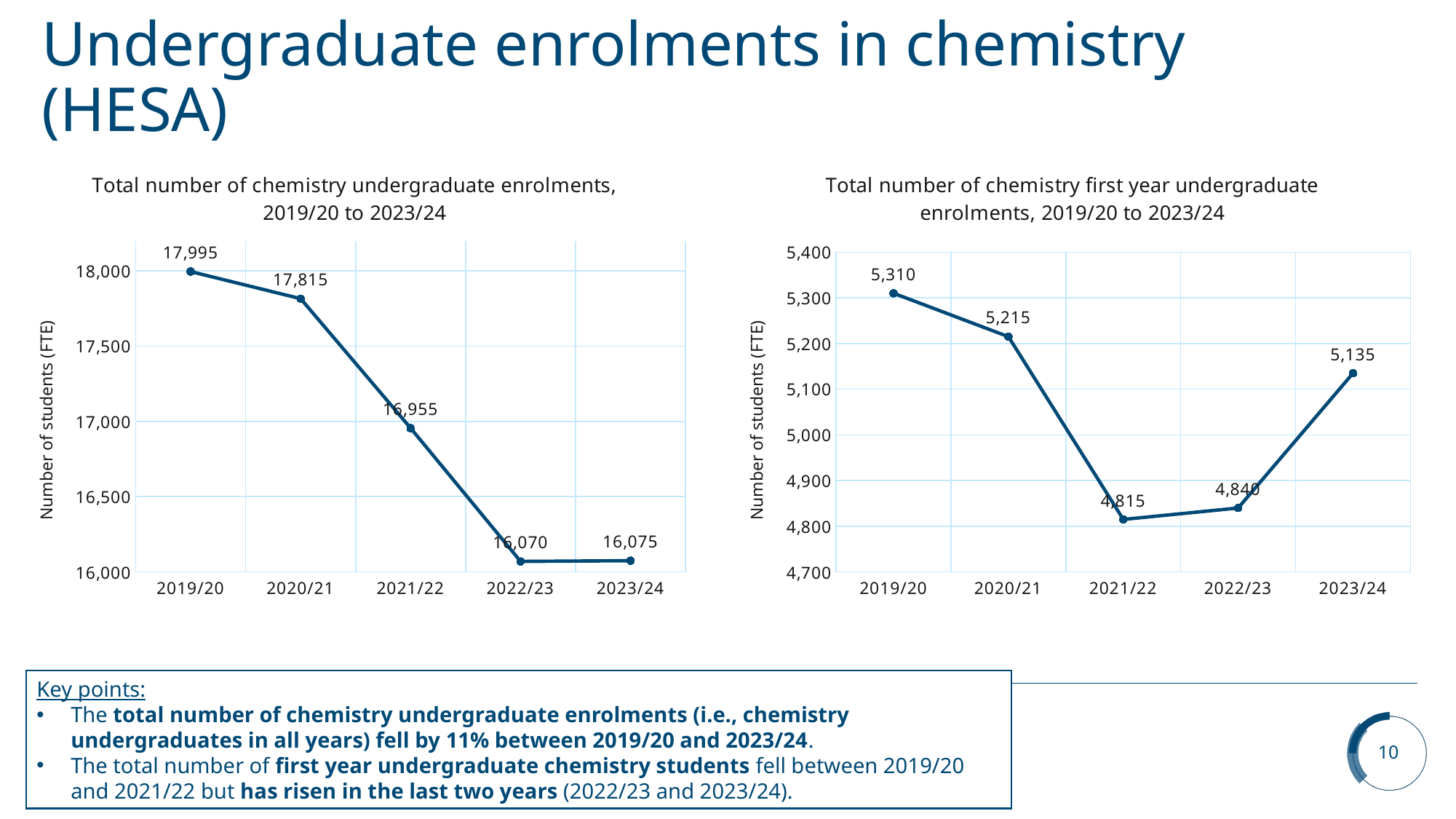
In the right chart (Total number of chemistry first year undergraduate enrolments), which year has the lowest value? 2021/22 How many data points are plotted in the right chart (Total number of chemistry first year undergraduate enrolments)? 5 What kind of chart is the left chart (Total number of chemistry undergraduate enrolments)? Line chart In the left chart (Total number of chemistry undergraduate enrolments), what is the value for 2021/22? 16,955 In the right chart (Total number of chemistry first year undergraduate enrolments), which is larger, the value for 2019/20 or the value for 2023/24? 2019/20 In the right chart (Total number of chemistry first year undergraduate enrolments), what is the value for 2023/24? 5,135 In the left chart (Total number of chemistry undergraduate enrolments), is the value for 2020/21 greater or less than 17,500? greater In the left chart (Total number of chemistry undergraduate enrolments), do the values generally rise or fall from 2019/20 to 2023/24? Fall In the left chart (Total number of chemistry undergraduate enrolments), what is the value for 2019/20? 17,995 In the right chart (Total number of chemistry first year undergraduate enrolments), what is the difference between the 2020/21 and 2021/22 values? 400 In the left chart (Total number of chemistry undergraduate enrolments), what is the difference between the 2019/20 and 2023/24 values? 1,920 In the left chart (Total number of chemistry undergraduate enrolments), which year has the highest value? 2019/20